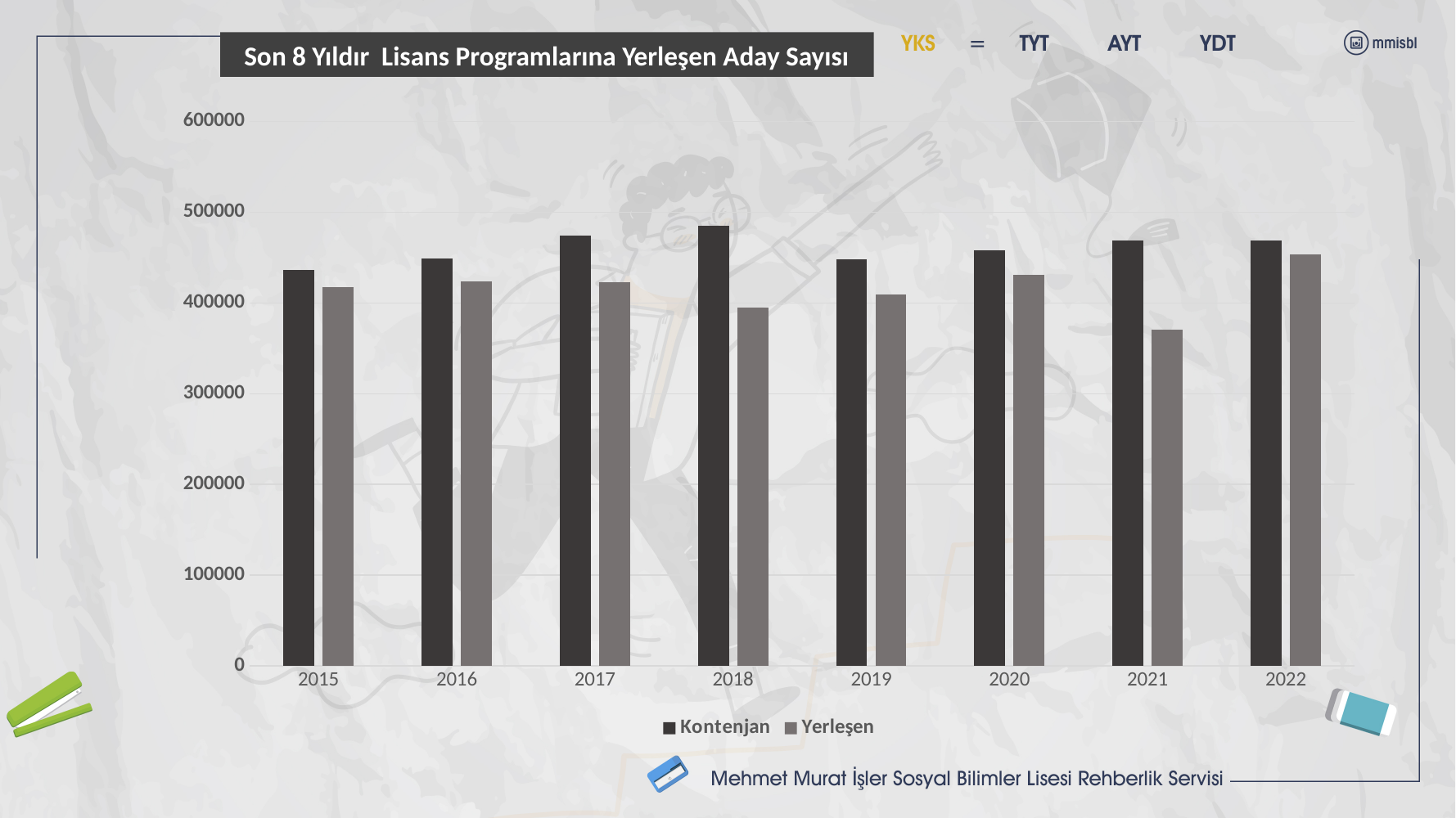
Is the Kontenjan value for 2018 greater or less than 400000? greater What are the two series named in the legend? Kontenjan and Yerleşen How many years are shown on the x axis of the chart? 8 What is the title of the chart? Son 8 Yıldır Lisans Programlarına Yerleşen Aday Sayısı Is the Yerleşen value for 2021 greater or less than 400000? less In 2021, which is larger: Kontenjan or Yerleşen? Kontenjan How many series does the chart's legend list? 2 Does the Yerleşen value rise or fall from 2020 to 2021? fall In which year is the Kontenjan value highest? 2018 What kind of chart is shown on the slide? bar chart In which year is the Yerleşen value lowest? 2021 In which year is the Yerleşen value highest? 2022